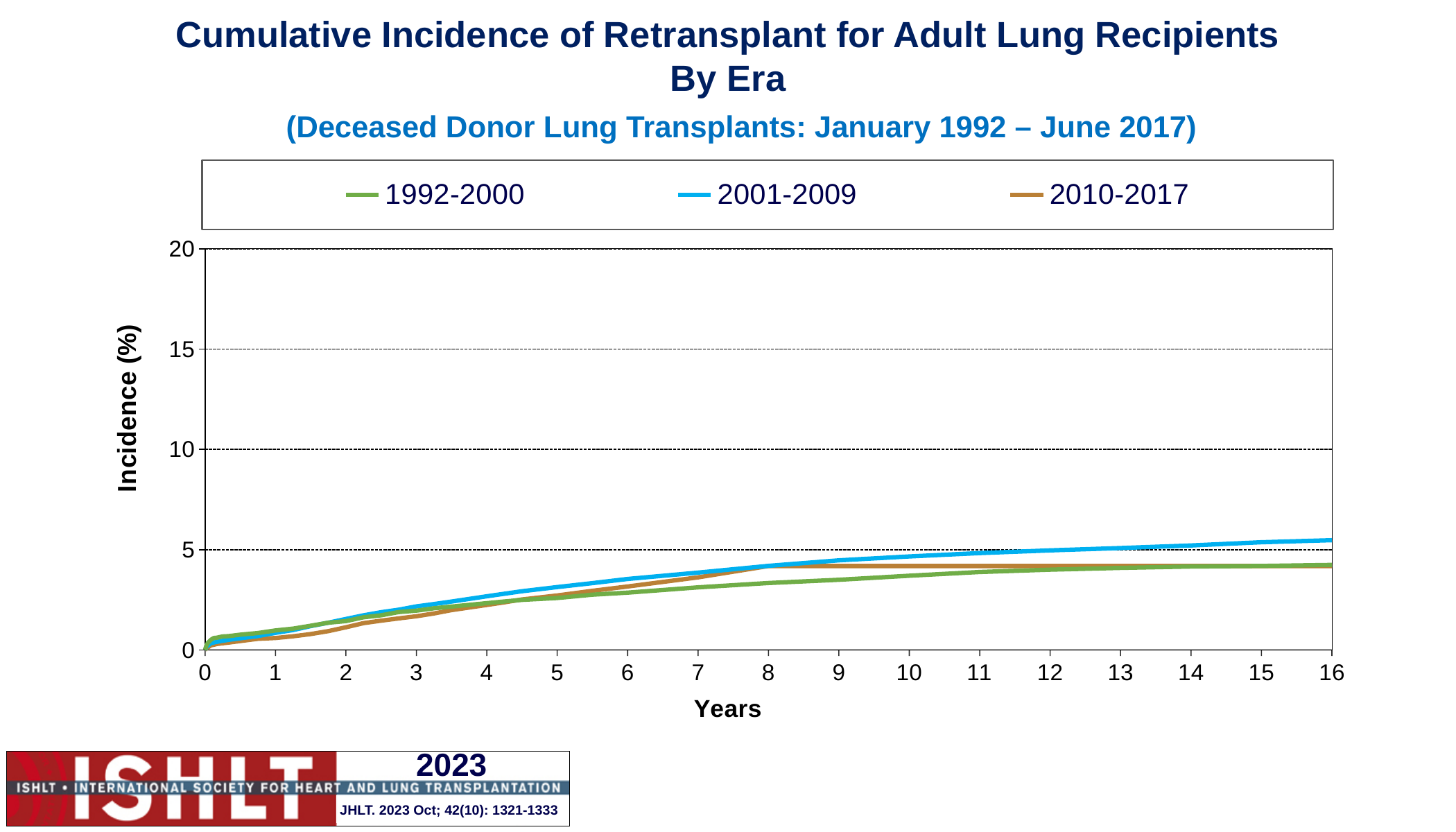
What is the label of the y axis? Incidence (%) How many series does the legend list? 3 Is the value for the 1992-2000 era at 4 years greater or less than 5? less At 10 years, which era has the higher cumulative incidence, 1992-2000 or 2001-2009? 2001-2009 Which eras are listed in the legend? 1992-2000, 2001-2009, 2010-2017 Is the value for the 2001-2009 era at 16 years greater or less than 5? greater What kind of chart is shown on the slide? Line chart Which era has the highest cumulative incidence at 16 years? 2001-2009 Does the cumulative incidence for the 2001-2009 era rise or fall as years increase? Rise Is the value for the 1992-2000 era at 16 years greater or less than 5? less At 16 years, which era has the higher cumulative incidence, 1992-2000 or 2001-2009? 2001-2009